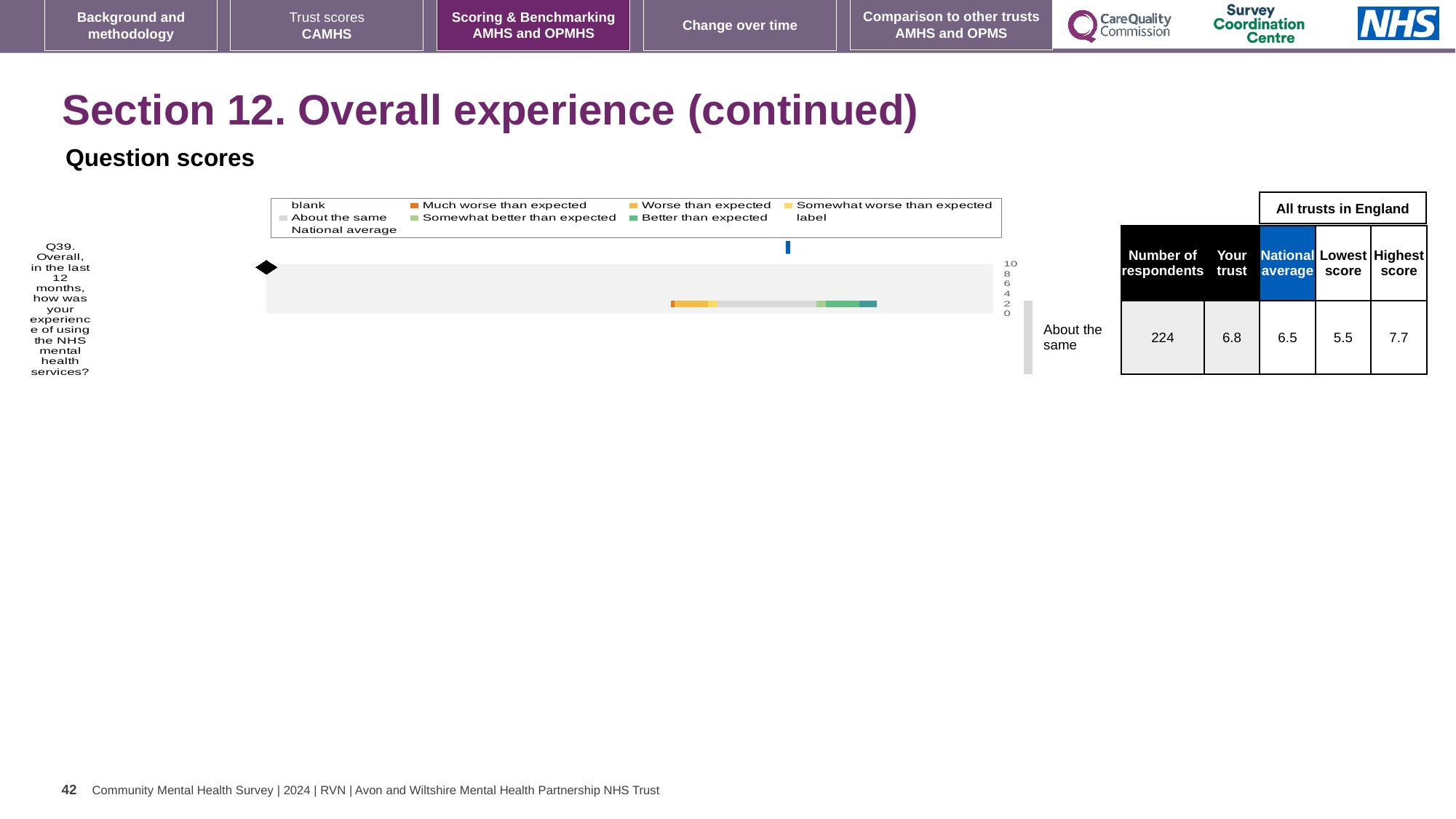
In the table, what is the highest score among all trusts in England for Q39? 7.7 How many entries does the chart legend list? 9 What kind of chart is shown on the slide? bar chart How many questions (categories) are plotted in the chart? 1 In the table, what is the national average score for Q39? 6.5 Which question is plotted in the chart? Q39. Overall, in the last 12 months, how was your experience of using the NHS mental health services? In the table, what is the number of respondents for Q39? 224 In the table, what is the lowest score among all trusts in England for Q39? 5.5 What is the highest value shown on the chart's axis? 10 In the table, what is the 'Your trust' score for Q39? 6.8 Which legend entry is shown in dark orange? Much worse than expected Is the 'Your trust' score for Q39 higher or lower than the national average? higher